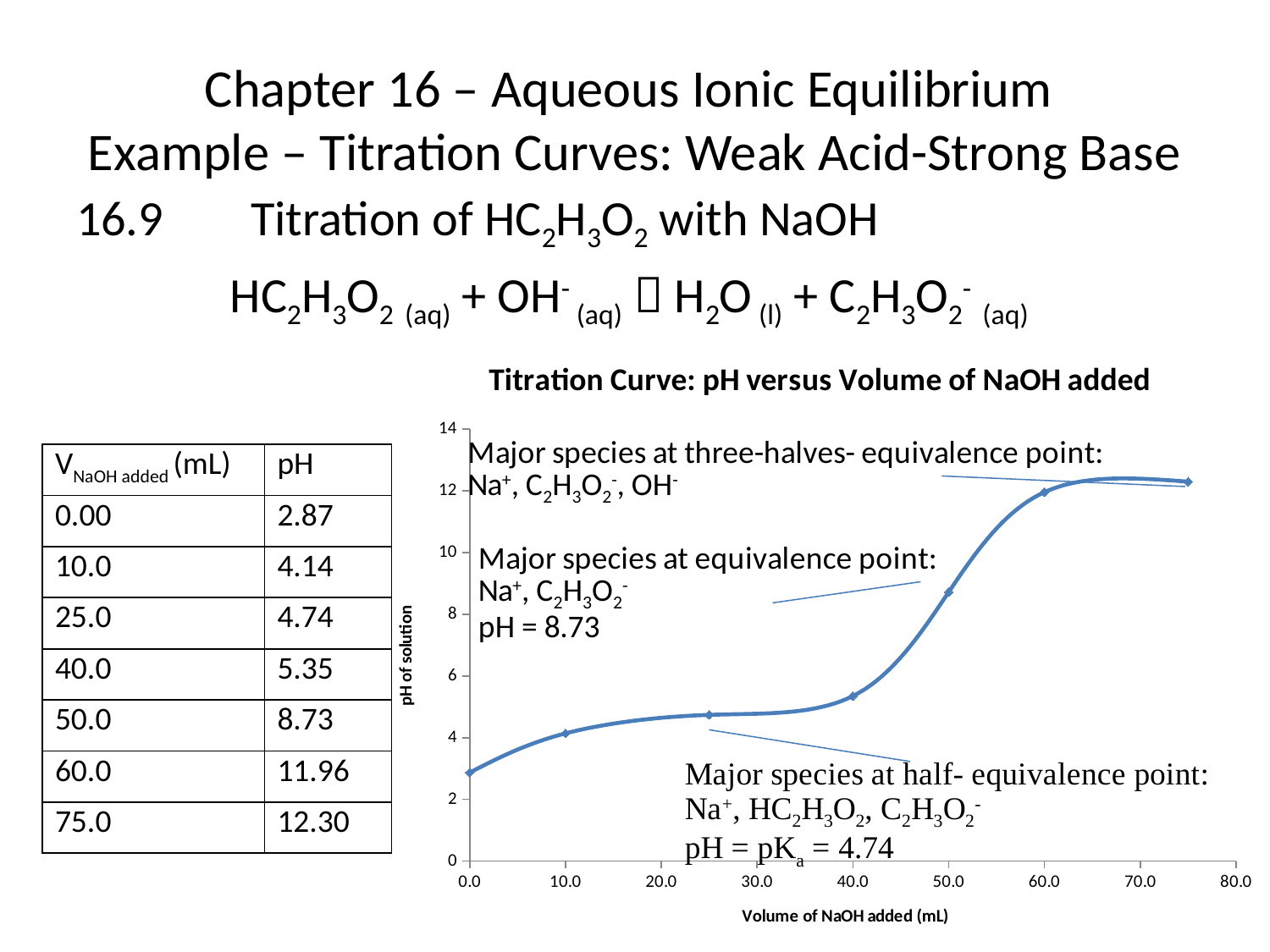
Is the pH at 60.0 mL of NaOH added greater or less than 10? greater What is the pH at the half-equivalence point (25.0 mL of NaOH added)? 4.74 What kind of chart is shown on the slide? line chart What is the difference between the pH at the equivalence point and the pH at the half-equivalence point? 3.99 How many data points are plotted on the titration curve? 7 What is the pH at the equivalence point (50.0 mL of NaOH added)? 8.73 Does the pH rise or fall as the volume of NaOH added increases along the x axis? rises At which volume of NaOH added is the pH lowest? 0.0 mL What is the label of the x axis of the chart? Volume of NaOH added (mL) At which volume of NaOH added is the pH highest? 75.0 mL Is the pH at 10.0 mL of NaOH added greater or less than 6? less What is the title of the chart? Titration Curve: pH versus Volume of NaOH added